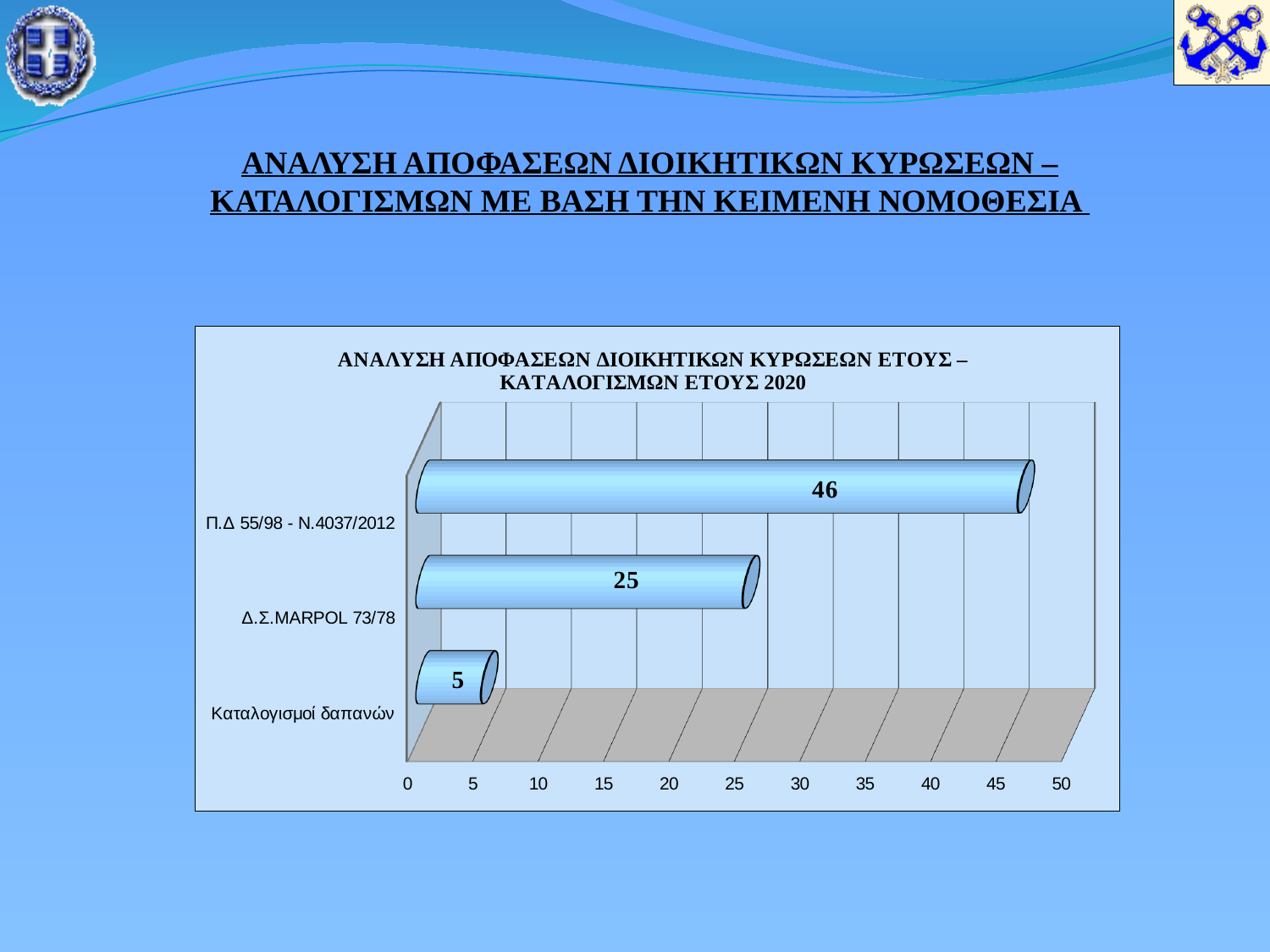
What is the difference between the values for Π.Δ 55/98 - Ν.4037/2012 and Δ.Σ.MARPOL 73/78? 21 What kind of chart is shown on the slide? bar chart What is the value for Δ.Σ.MARPOL 73/78? 25 What is the difference between the values for Δ.Σ.MARPOL 73/78 and Καταλογισμοί δαπανών? 20 What is the maximum value shown on the horizontal axis of the chart? 50 Which is larger, the value for Δ.Σ.MARPOL 73/78 or the value for Καταλογισμοί δαπανών? Δ.Σ.MARPOL 73/78 What is the value for Καταλογισμοί δαπανών? 5 Which category has the lowest value? Καταλογισμοί δαπανών Which category has the highest value? Π.Δ 55/98 - Ν.4037/2012 Is the value for Π.Δ 55/98 - Ν.4037/2012 greater or less than 40? greater How many categories are shown in the chart? 3 What is the value for Π.Δ 55/98 - Ν.4037/2012? 46